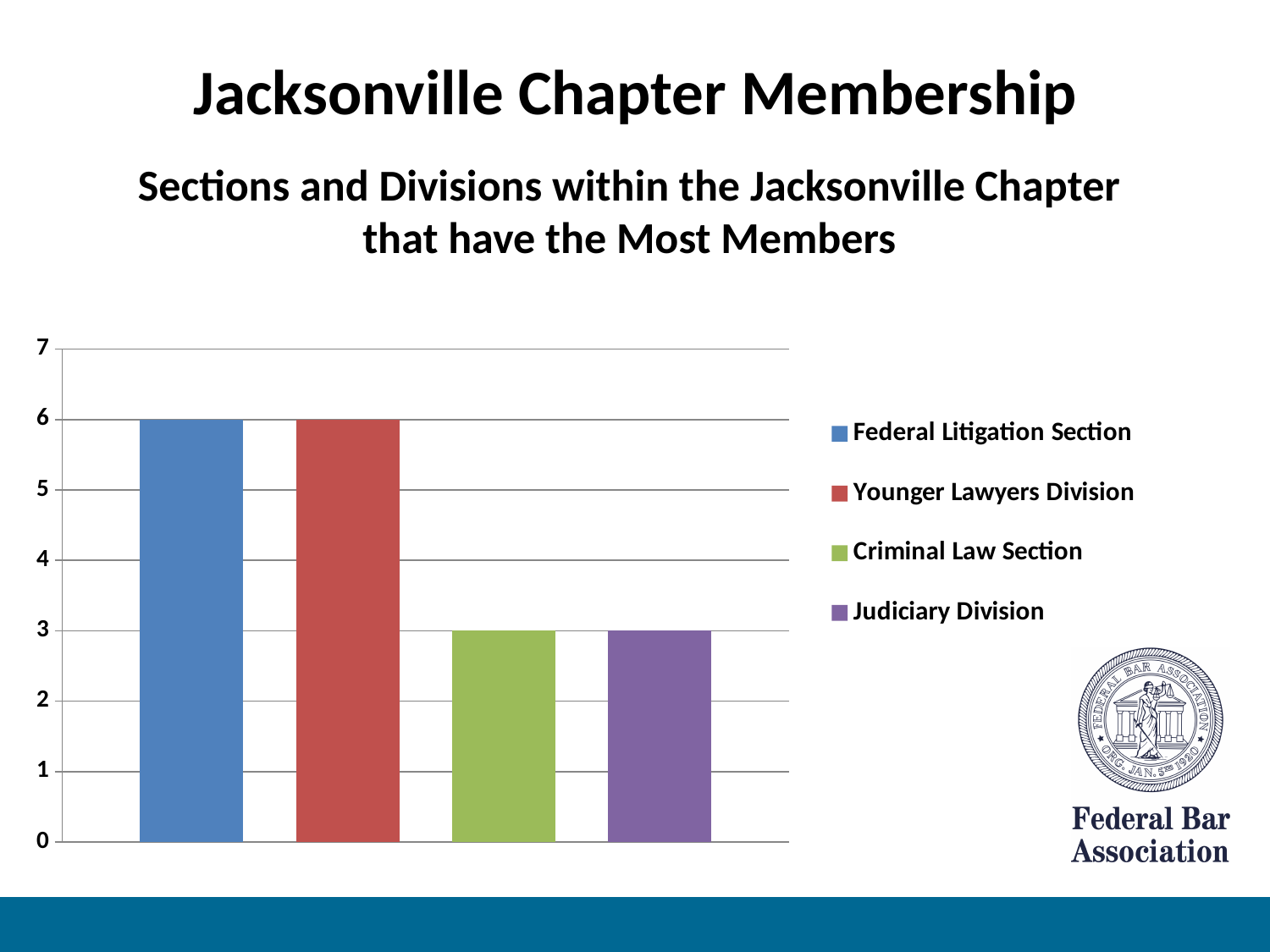
What is the value for Younger Lawyers Division? 6 What is the difference between the values for Federal Litigation Section and Criminal Law Section? 3 Is the value for Criminal Law Section greater or less than 4? less Which is larger, the value for Younger Lawyers Division or the value for Judiciary Division? Younger Lawyers Division How many bars are plotted in the chart? 4 What is the value for Judiciary Division? 3 What kind of chart is shown on the slide? bar chart What is the value for Criminal Law Section? 3 What is the difference between the values for Younger Lawyers Division and Judiciary Division? 3 What is the value for Federal Litigation Section? 6 Is the value for Federal Litigation Section greater or less than 5? greater How many entries does the legend list? 4